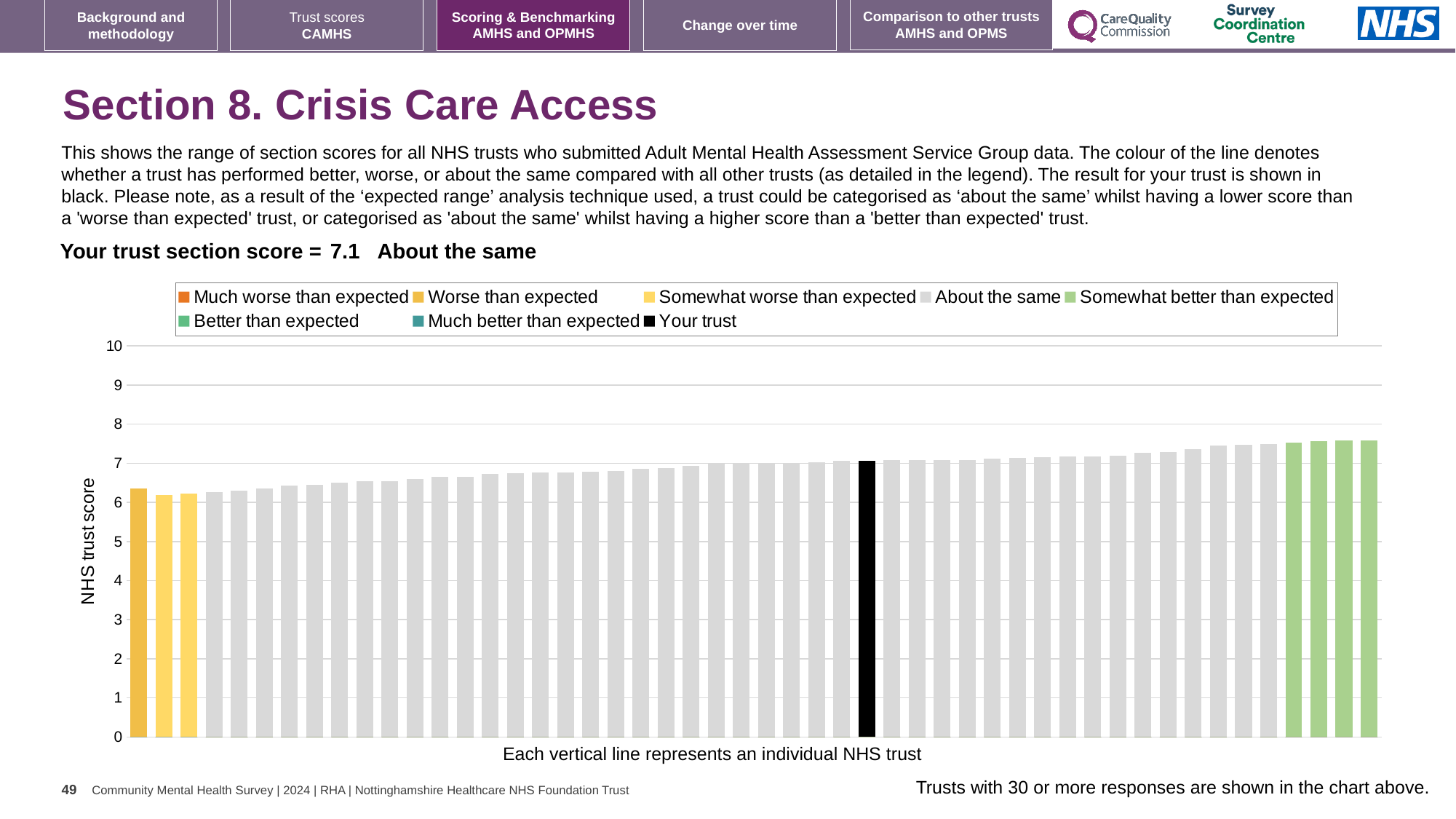
Is the value of the black 'Your trust' bar greater or less than 5? greater What is the section score for your trust shown on the slide? 7.1 What colour is used for the 'Your trust' bar in the legend? black Is the value of the shortest bar in the chart greater or less than 7? less Do the bar values rise or fall from left to right across the chart? rise Which category is your trust placed in for this section? About the same What is the title of the vertical axis? NHS trust score Is the value of the tallest bar in the chart greater or less than 8? less How many entries does the chart legend list? 8 What kind of chart is shown on the slide? bar chart